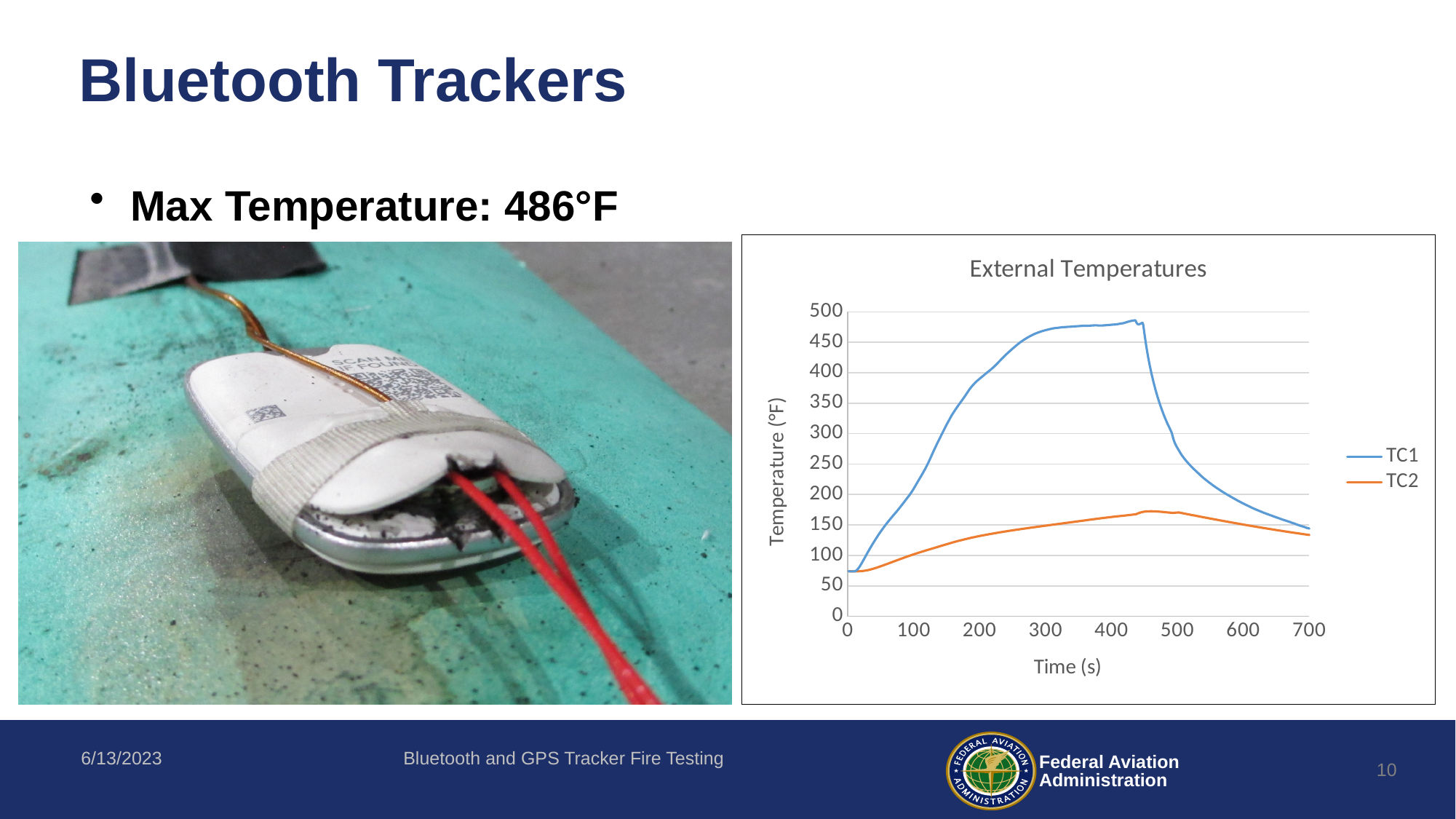
At 200 s, is the TC2 temperature greater or less than 100? greater At 500 s, is the TC1 temperature greater or less than 300? less What kind of chart is shown on the slide? line chart At 300 s, is the TC1 temperature greater or less than 400? greater Which series reaches the higher peak temperature in the External Temperatures chart, TC1 or TC2? TC1 At 300 s, which series has the higher temperature, TC1 or TC2? TC1 Does the TC1 temperature rise or fall between 0 s and 300 s? rise What is the label of the y axis of the External Temperatures chart? Temperature (°F) Does the TC1 temperature rise or fall between 450 s and 700 s? fall What is the title of the chart on the slide? External Temperatures How many series does the legend of the External Temperatures chart list? 2